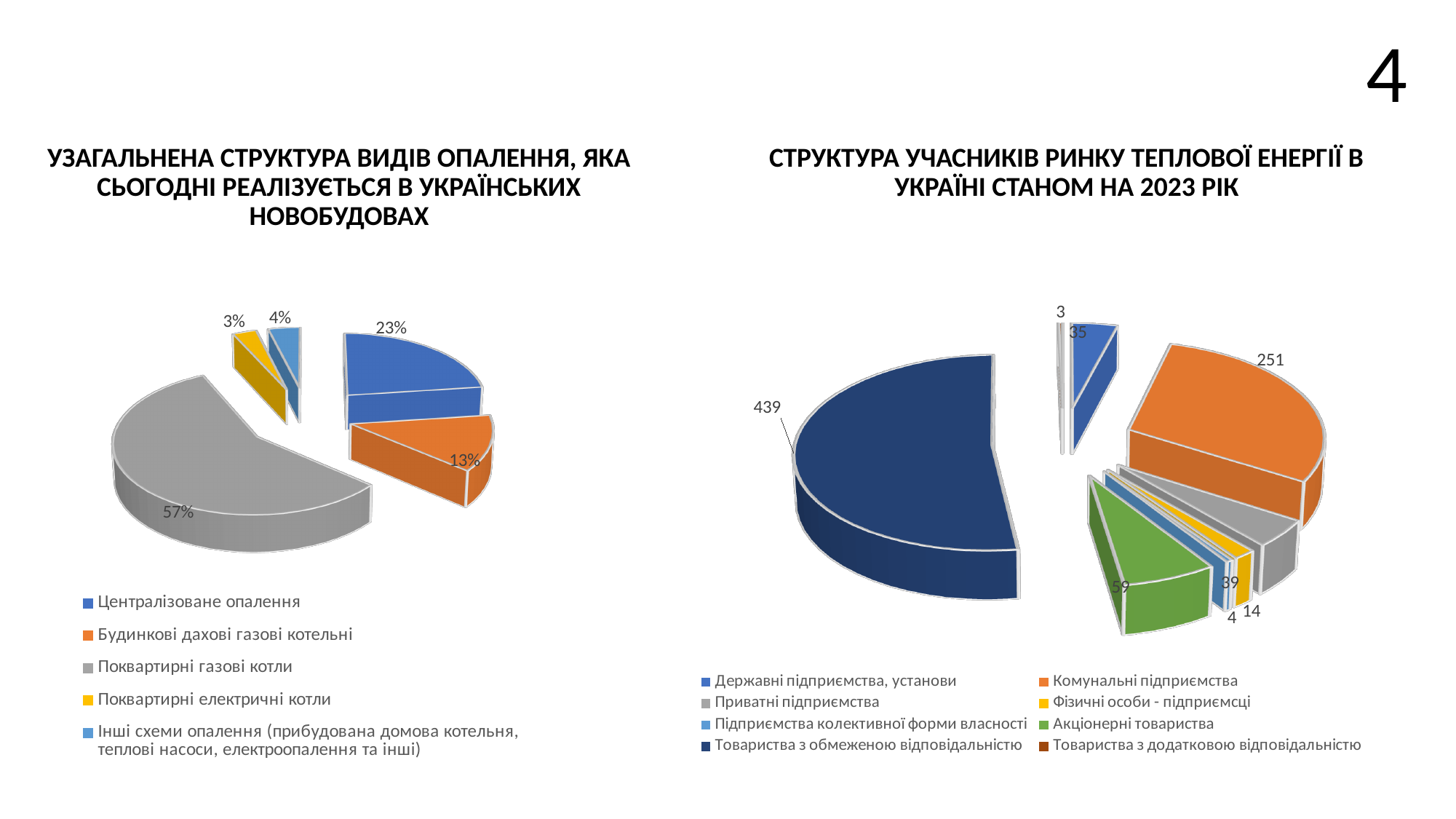
In the right chart (Структура учасників ринку теплової енергії), what value is shown for Акціонерні товариства? 59 In the right chart (Структура учасників ринку теплової енергії), what value is shown for Товариства з обмеженою відповідальністю? 439 In the right chart (Структура учасників ринку теплової енергії), what value is shown for Комунальні підприємства? 251 In the left chart (Узагальнена структура видів опалення), how many categories does the legend list? 5 What type of chart is the left chart (Узагальнена структура видів опалення)? Pie chart In the left chart (Узагальнена структура видів опалення), how many percentage points larger is Централізоване опалення than Будинкові дахові газові котельні? 10 In the left chart (Узагальнена структура видів опалення), which category has the largest share? Поквартирні газові котли In the left chart (Узагальнена структура видів опалення), what share is shown for Централізоване опалення? 23% In the left chart (Узагальнена структура видів опалення), what share is shown for Поквартирні газові котли? 57% In the right chart (Структура учасників ринку теплової енергії), how many categories does the legend list? 8 In the left chart (Узагальнена структура видів опалення), which category has the smallest share? Поквартирні електричні котли In the right chart (Структура учасників ринку теплової енергії), which is larger: Державні підприємства, установи or Комунальні підприємства? Комунальні підприємства